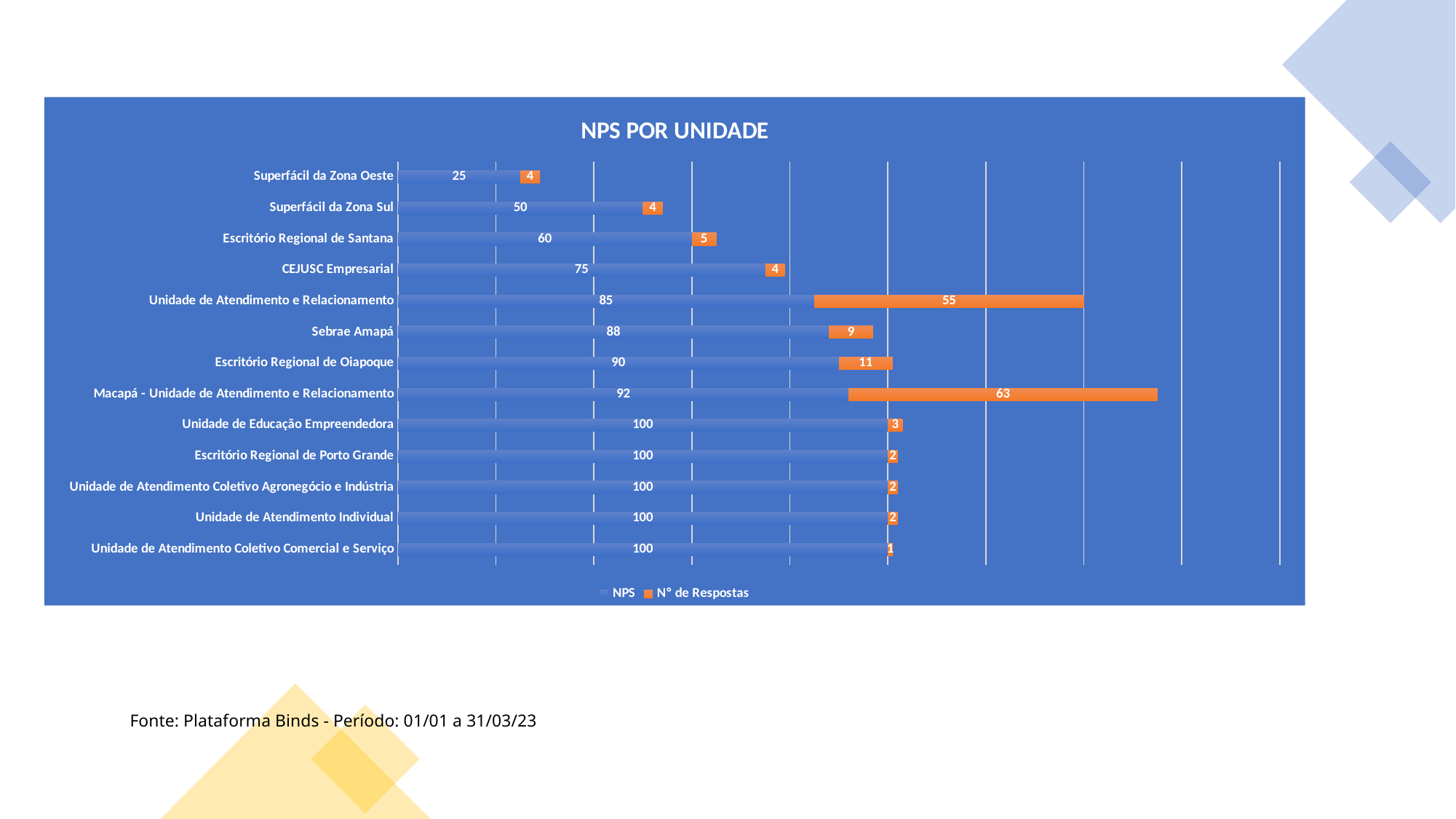
How many units are shown in the chart? 13 What is the total of the stacked bar for Unidade de Atendimento e Relacionamento? 140 What is the NPS value for Superfácil da Zona Oeste? 25 What is the title of the chart? NPS POR UNIDADE How many series does the legend list? 2 Which unit has the lowest NPS value? Superfácil da Zona Oeste What is the NPS value for Escritório Regional de Oiapoque? 90 Which has a larger N° de Respostas value, Sebrae Amapá or Escritório Regional de Santana? Sebrae Amapá What is the N° de Respostas value for Macapá - Unidade de Atendimento e Relacionamento? 63 What is the difference between the NPS values of CEJUSC Empresarial and Superfácil da Zona Sul? 25 Which unit has the highest N° de Respostas value? Macapá - Unidade de Atendimento e Relacionamento What kind of chart is shown on the slide? Stacked bar chart